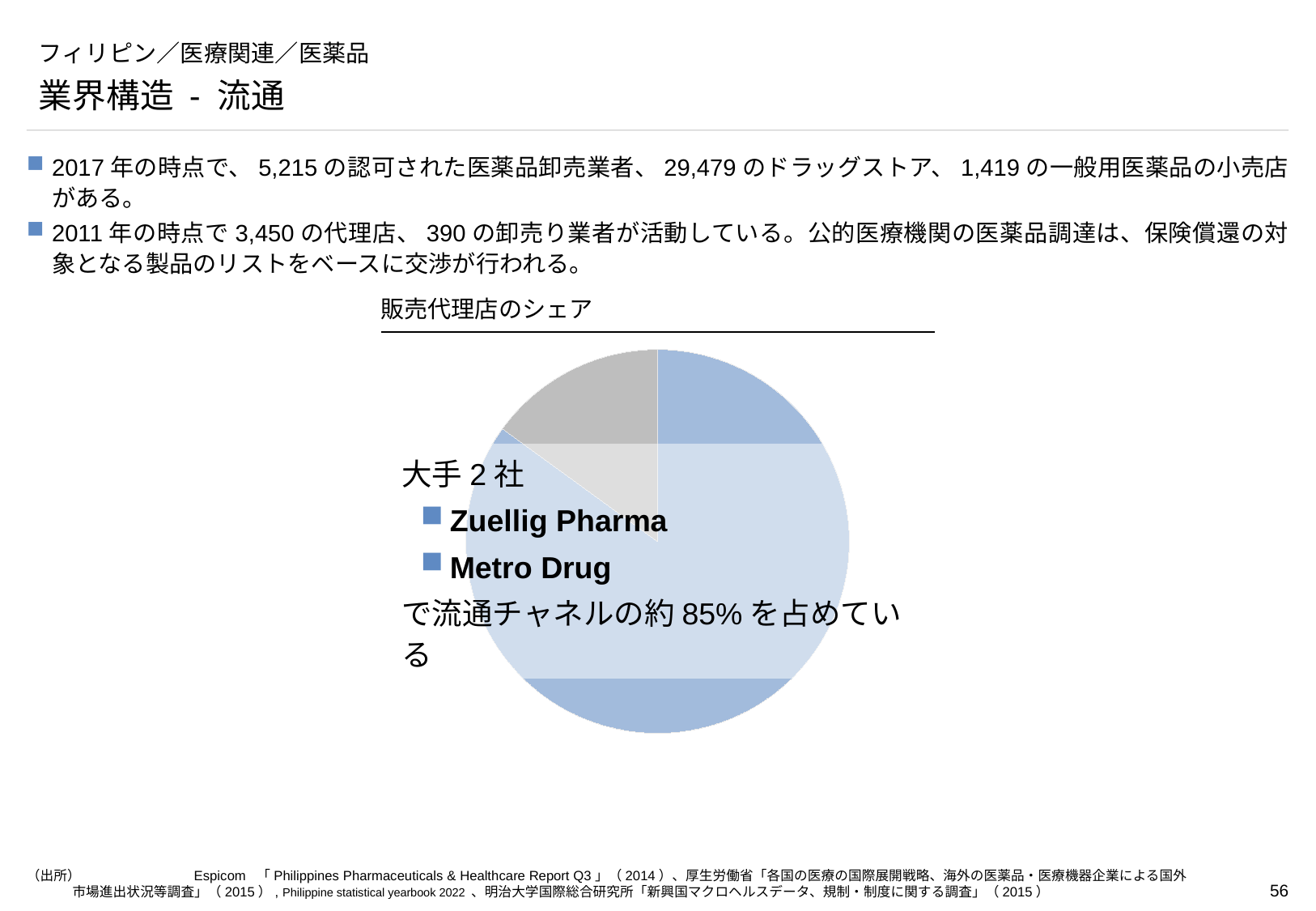
According to the text on the chart, what share of the distribution channel do the top two companies (Zuellig Pharma and Metro Drug) account for? 約85% What is the title of the pie chart? 販売代理店のシェア Which colour slice is the largest in the pie chart? blue How many slices does the pie chart have? 2 What kind of chart is shown on the slide? pie chart